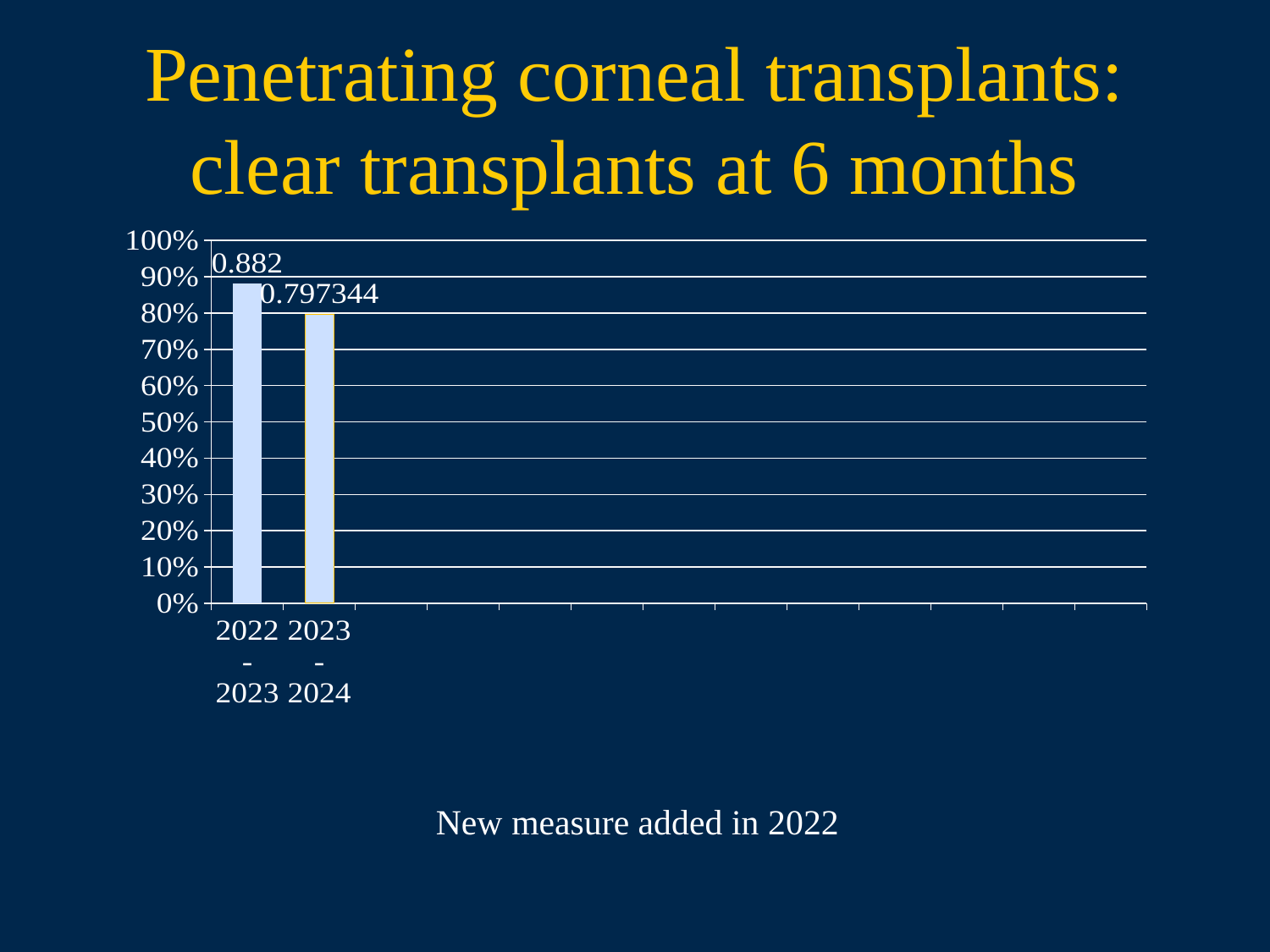
Is the value for 2022-2023 greater or less than 80%? greater Which period has the lowest bar? 2023-2024 Do the values rise or fall from 2022-2023 to 2023-2024? fall Which is larger, the value for 2022-2023 or the value for 2023-2024? 2022-2023 What kind of chart is shown on the slide? bar chart What is the data label shown on the bar for 2023-2024? 0.797344 Which period has the highest bar? 2022-2023 What is the title of the slide? Penetrating corneal transplants: clear transplants at 6 months How many bars are plotted on the chart? 2 What is the difference between the labelled values for 2022-2023 and 2023-2024? 0.084656 Is the value for 2023-2024 greater or less than 70%? greater What is the data label shown on the bar for 2022-2023? 0.882